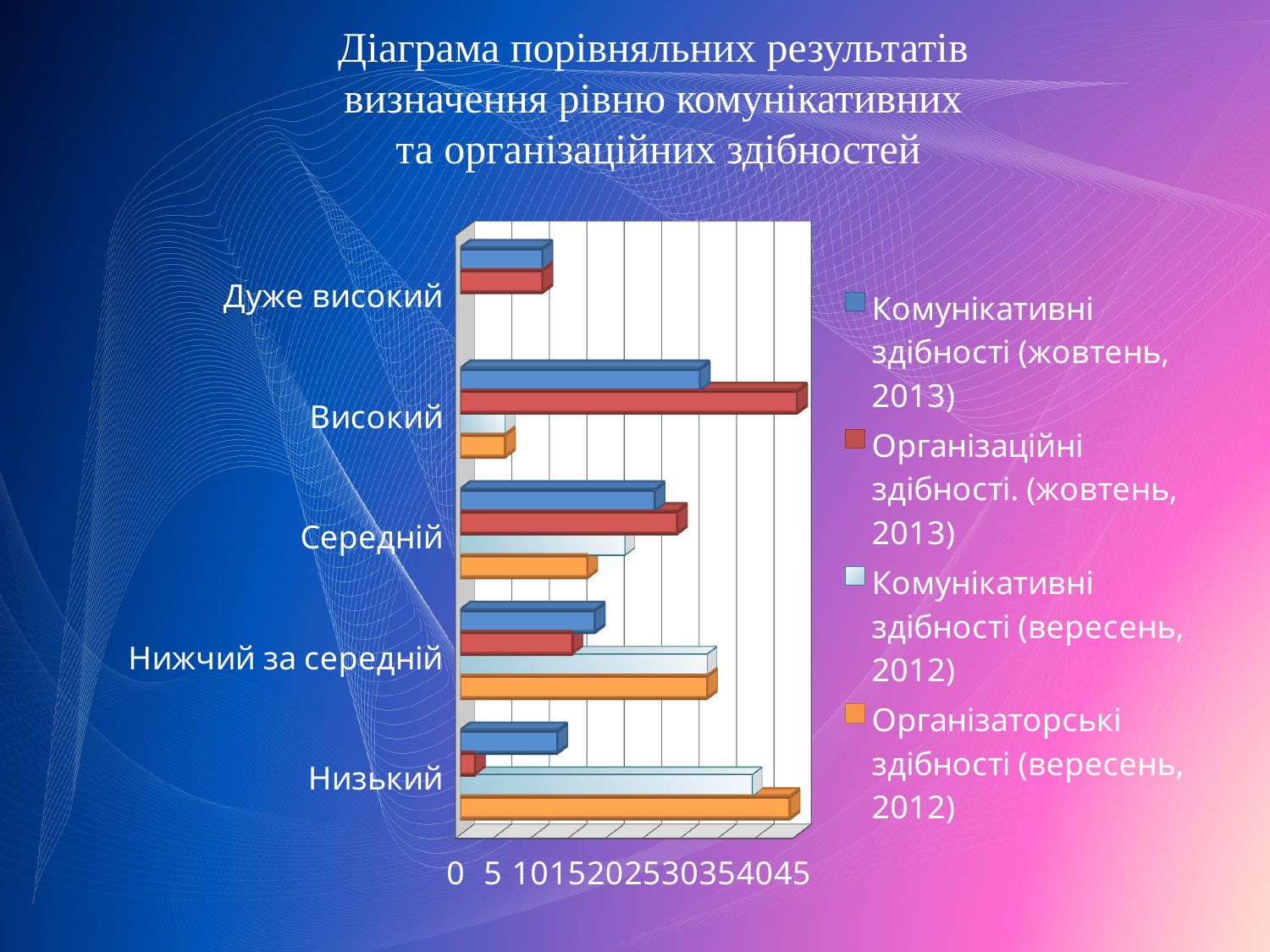
Is the value of Комунікативні здібності (жовтень, 2013) for Високий greater or less than 25? greater How many categories are shown on the vertical axis of the chart? 5 Is the value of Комунікативні здібності (вересень, 2012) for Низький greater or less than 30? greater For the series Організаторські здібності (вересень, 2012), which category has the highest value? Низький For the series Організаційні здібності (жовтень, 2013), which category has the lowest value? Низький What kind of chart is shown on the slide? bar chart For the category Низький, which is larger: Комунікативні здібності (вересень, 2012) or Організаційні здібності (жовтень, 2013)? Комунікативні здібності (вересень, 2012) How many series does the legend list? 4 For the category Високий, which is larger: Організаційні здібності (жовтень, 2013) or Комунікативні здібності (жовтень, 2013)? Організаційні здібності (жовтень, 2013) For the series Організаційні здібності (жовтень, 2013), which category has the highest value? Високий What colour represents Організаторські здібності (вересень, 2012) in the legend? orange Is the value of Організаторські здібності (вересень, 2012) for Високий greater or less than 15? less